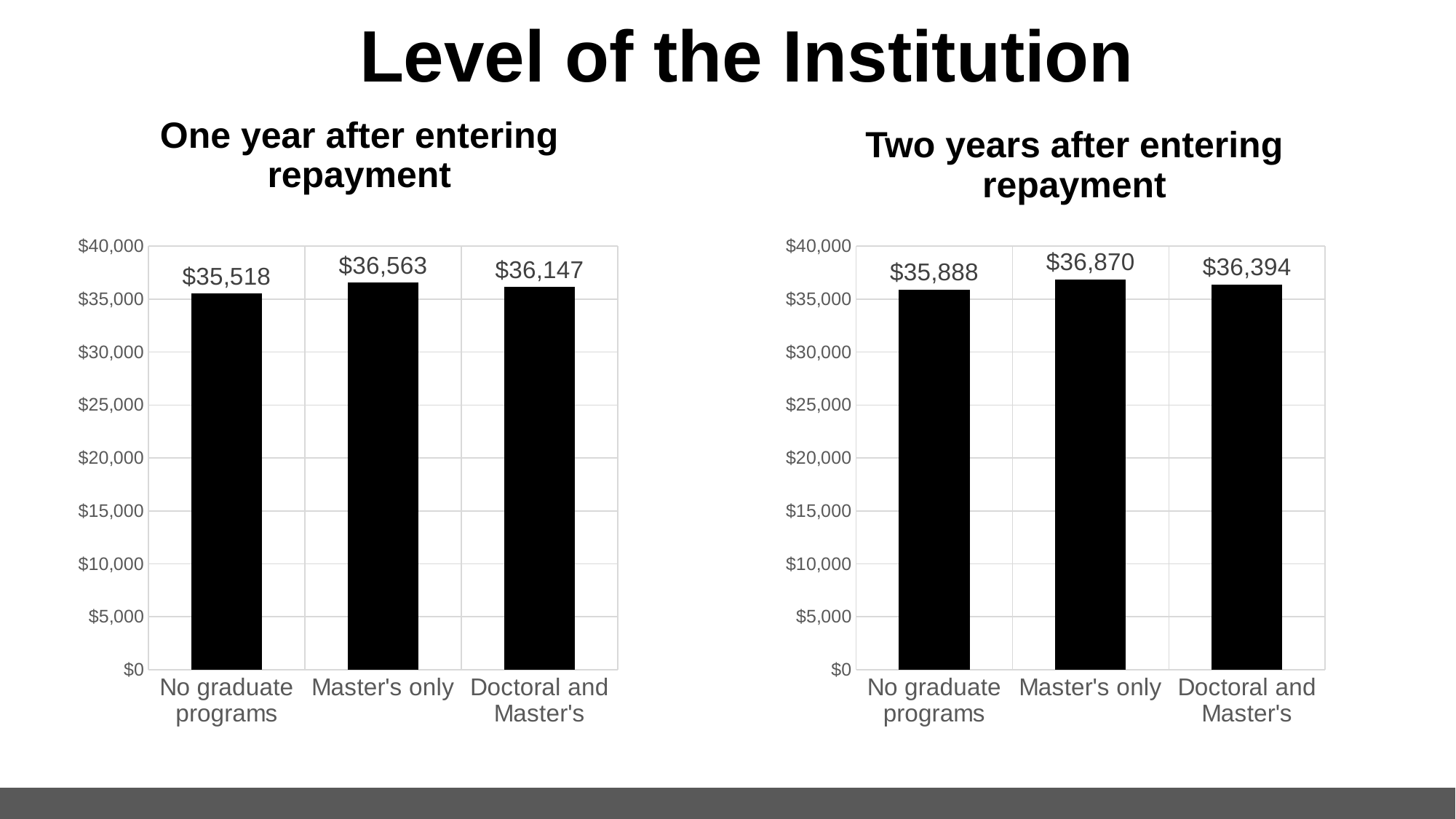
In the 'One year after entering repayment' chart, what is the difference between Master's only and No graduate programs? $1,045 In the 'One year after entering repayment' chart, what is the value for Master's only? $36,563 What type of chart is the 'One year after entering repayment' chart? bar chart In the 'One year after entering repayment' chart, is the value for No graduate programs greater or less than $35,000? greater In the 'Two years after entering repayment' chart, what is the value for No graduate programs? $35,888 In the 'Two years after entering repayment' chart, which is larger: Doctoral and Master's or No graduate programs? Doctoral and Master's In the 'Two years after entering repayment' chart, what is the difference between Master's only and Doctoral and Master's? $476 What is the title of the slide? Level of the Institution In the 'One year after entering repayment' chart, which category has the lowest value? No graduate programs How many categories are shown in the 'Two years after entering repayment' chart? 3 In the 'One year after entering repayment' chart, what is the value for Doctoral and Master's? $36,147 In the 'Two years after entering repayment' chart, which category has the highest value? Master's only